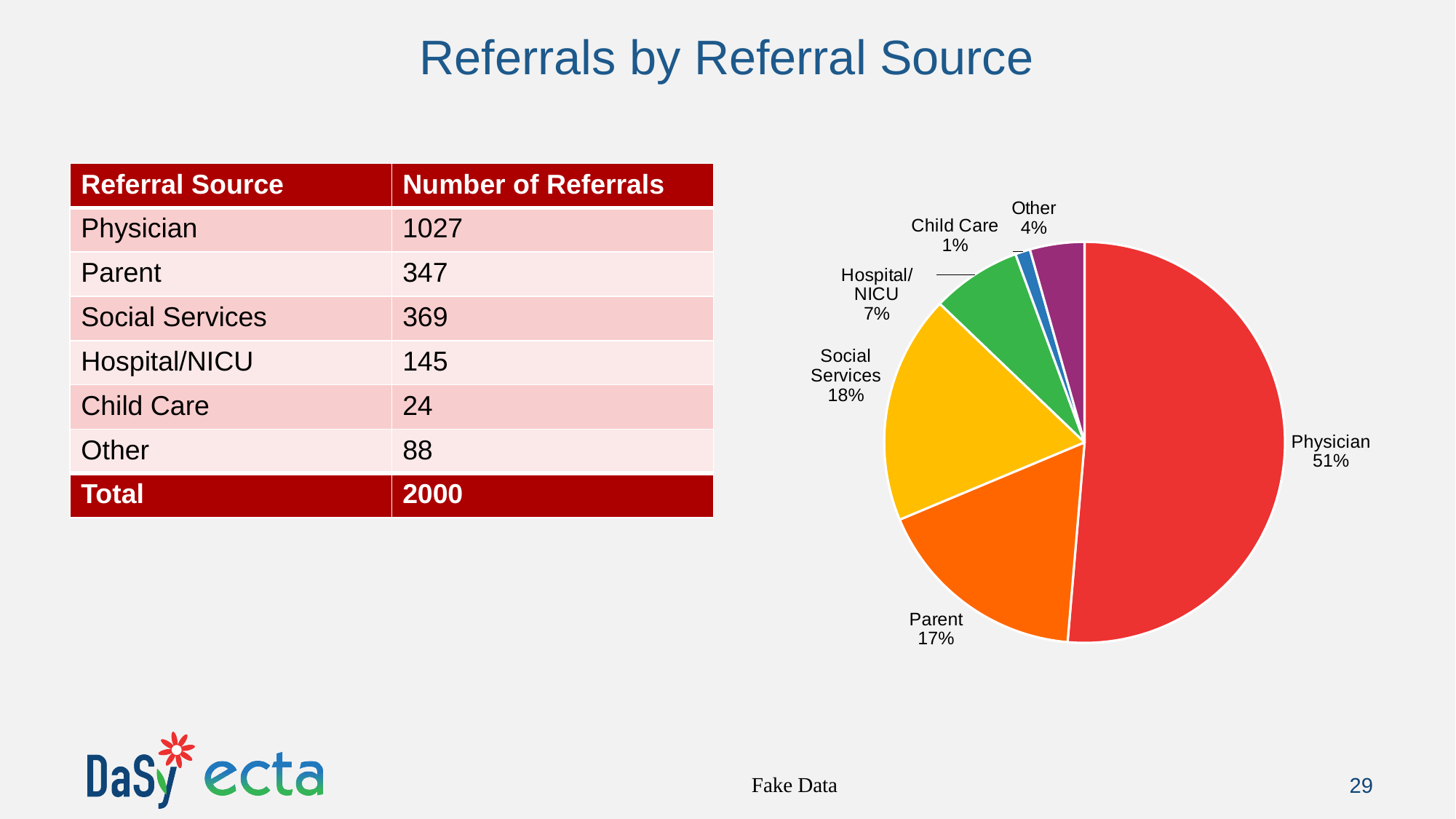
What type of chart is shown on the slide? pie chart What percentage is shown for Hospital/NICU in the pie chart? 7% What is the difference in percentage points between the Physician slice and the Social Services slice? 33 Which is larger in the pie chart, Social Services or Parent? Social Services What is the difference in percentage points between the Hospital/NICU slice and the Other slice? 3 Which referral source has the smallest slice of the pie? Child Care What percentage is shown for Social Services in the pie chart? 18% What is the title of the slide containing the pie chart? Referrals by Referral Source Which referral source has the largest slice of the pie? Physician How many slices does the pie chart have? 6 What share of the pie does Physician account for? 51% What percentage is shown for Parent in the pie chart? 17%